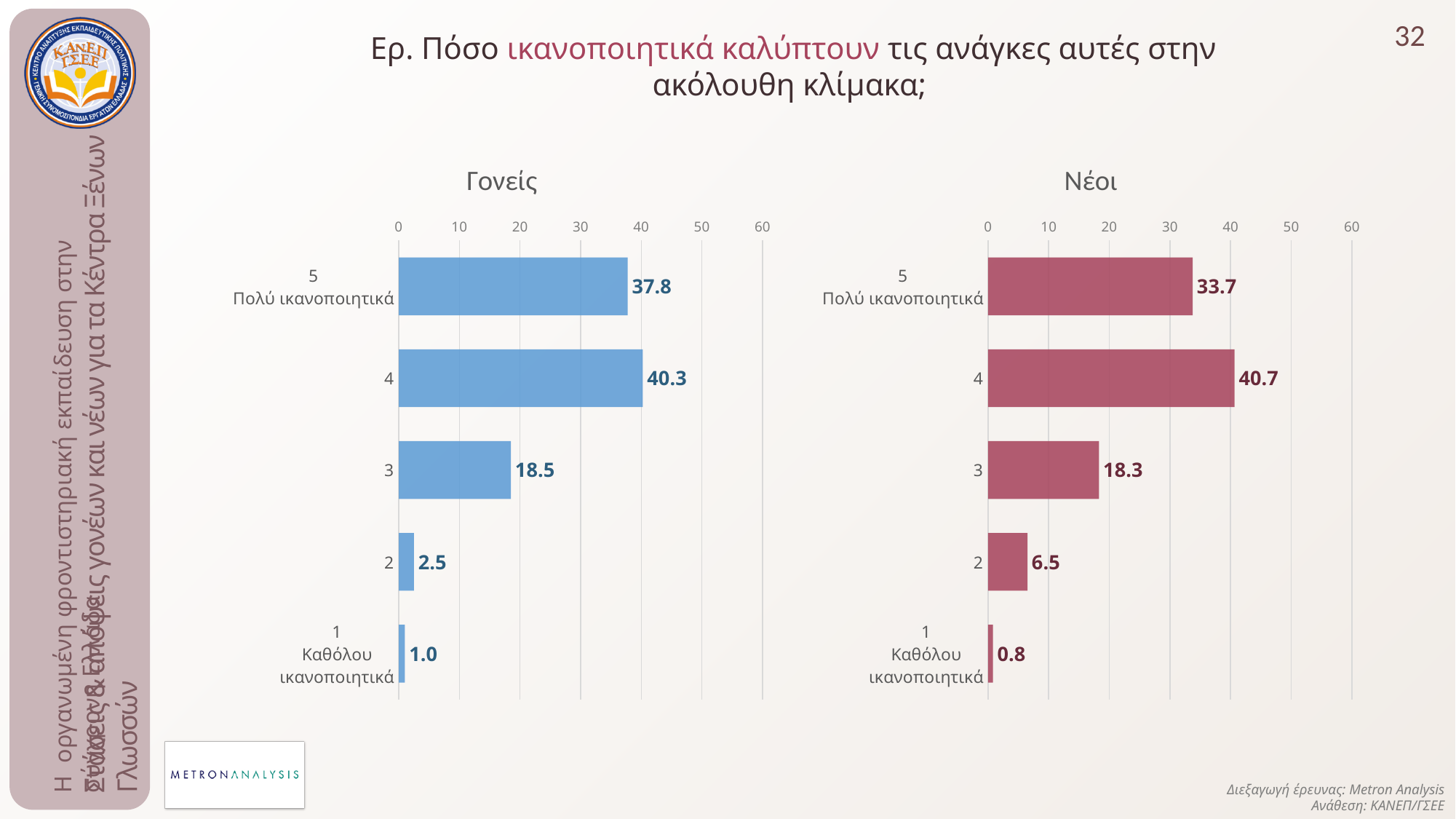
In the Γονείς chart, what is the difference between the values for category 4 and category 5? 2.5 What kind of chart is the Γονείς chart? bar chart In the Νέοι chart, what is the difference between the values for category 2 and category 1? 5.7 In the Γονείς chart, is the value for category 3 greater or less than 20? less In the Νέοι chart, what is the value for category 2? 6.5 How many categories are shown in the Νέοι chart? 5 In the Νέοι chart, which category has the lowest value? 1 (Καθόλου ικανοποιητικά) In the Γονείς chart, which category has the highest value? 4 In the Νέοι chart, what is the value for category 5 (Πολύ ικανοποιητικά)? 33.7 What colour are the bars in the Νέοι chart? red In the Γονείς chart, what is the value for category 4? 40.3 Which is larger: the value for category 2 in the Γονείς chart or the value for category 2 in the Νέοι chart? Νέοι